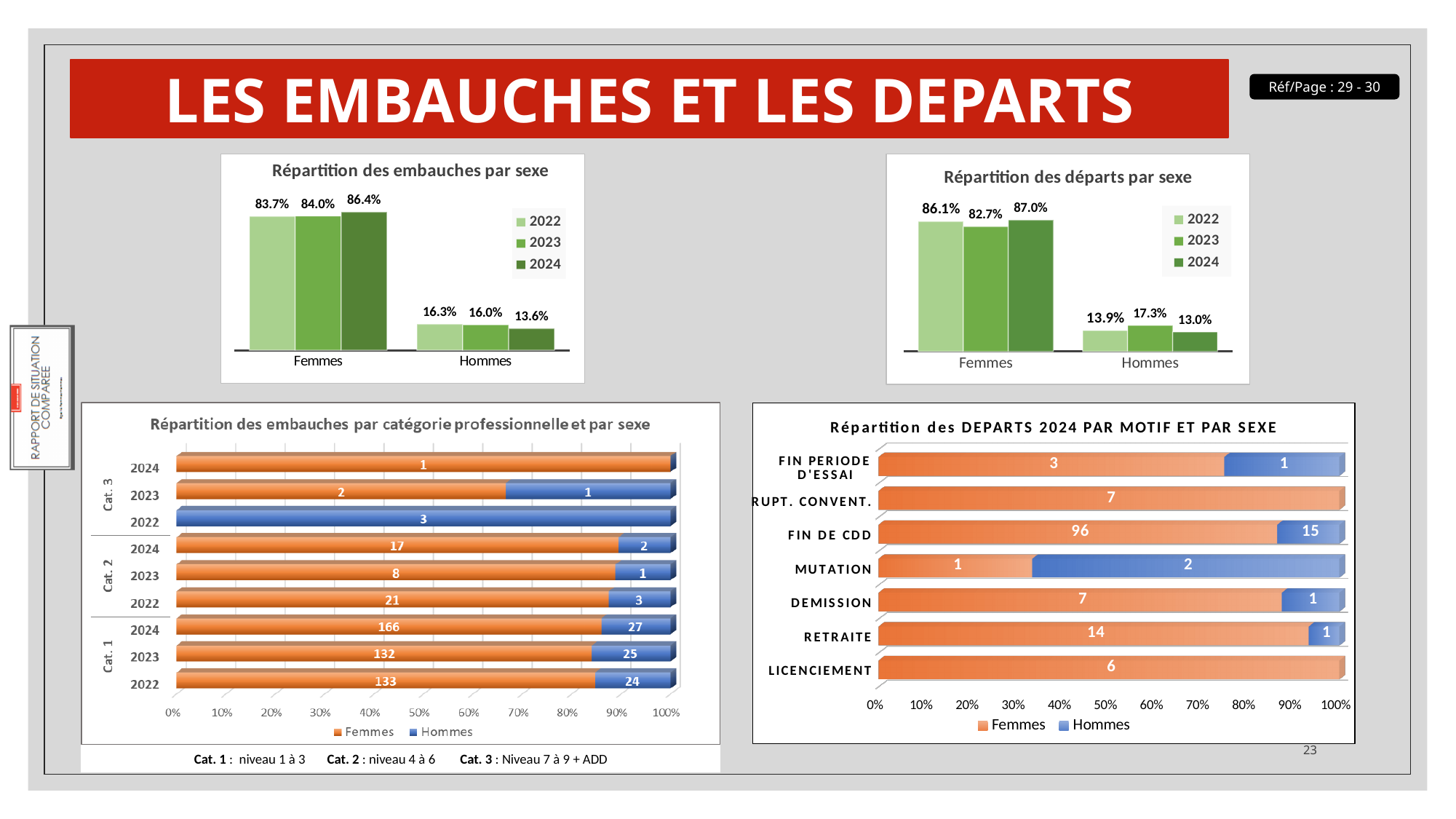
In the chart 'Répartition des embauches par catégorie professionnelle et par sexe', what is the total of the Cat. 1 2022 bar (Femmes plus Hommes)? 157 In the chart 'Répartition des embauches par sexe', what is the value for Femmes in 2024? 86.4% In the chart 'Répartition des embauches par sexe', which year has the lowest value for Hommes? 2024 In the chart 'Répartition des embauches par catégorie professionnelle et par sexe', how many Hommes were hired in Cat. 2 in 2022? 3 In the chart 'Répartition des DEPARTS 2024 PAR MOTIF ET PAR SEXE', how many motif categories are shown? 7 In the chart 'Répartition des DEPARTS 2024 PAR MOTIF ET PAR SEXE', what is the Femmes value for FIN DE CDD? 96 In the chart 'Répartition des départs par sexe', how many series does the legend list? 3 In the chart 'Répartition des départs par sexe', what is the difference between the Femmes values for 2024 and 2023? 4.3% In the chart 'Répartition des départs par sexe', what is the value for Hommes in 2023? 17.3% What kind of chart is 'Répartition des DEPARTS 2024 PAR MOTIF ET PAR SEXE'? Stacked bar chart In the chart 'Répartition des DEPARTS 2024 PAR MOTIF ET PAR SEXE', what is the total of the FIN DE CDD bar (Femmes plus Hommes)? 111 In the chart 'Répartition des embauches par catégorie professionnelle et par sexe', how many Femmes were hired in Cat. 1 in 2024? 166